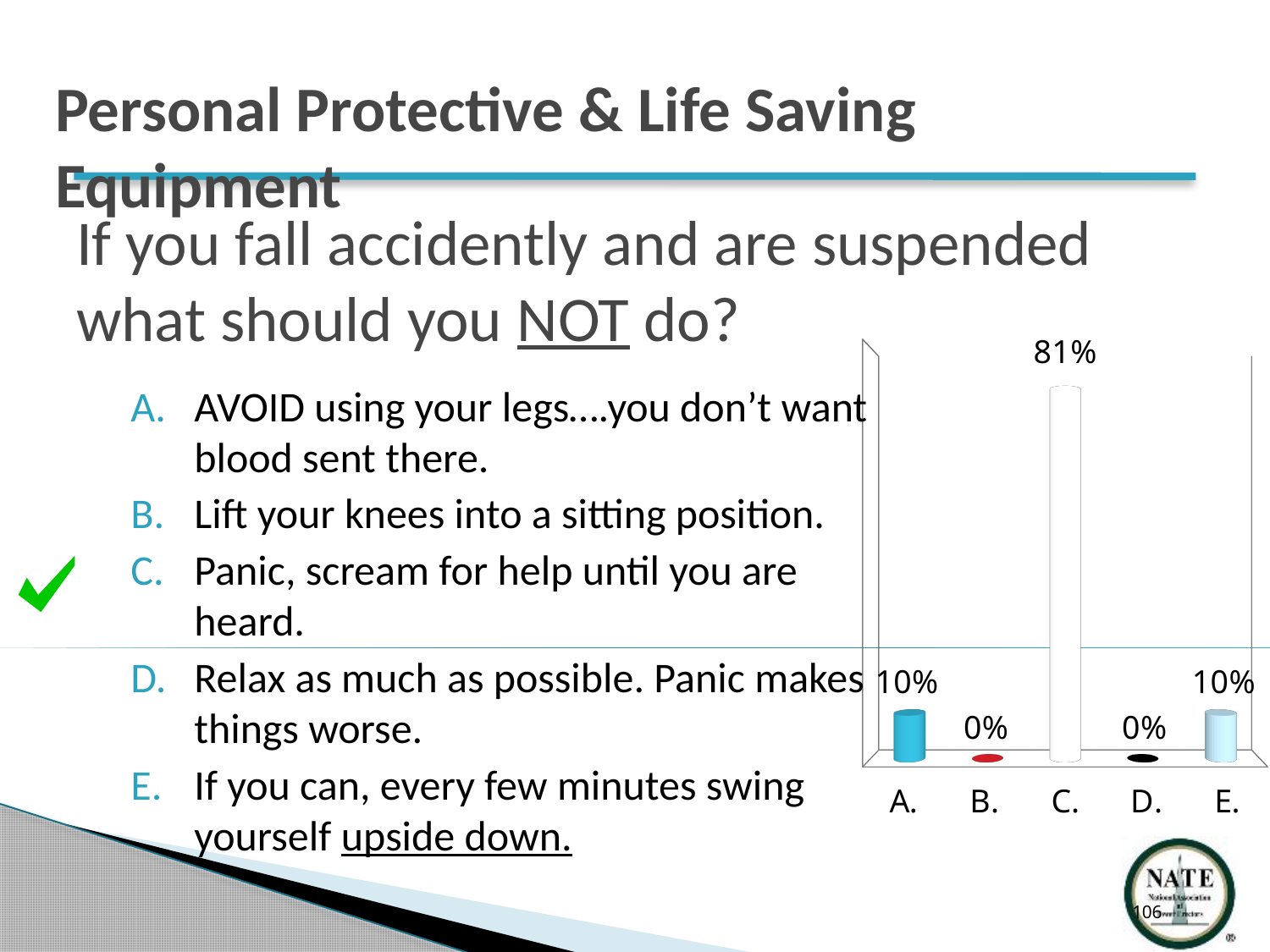
What is the difference between the values for E. and D. in the chart? 10% What is the value for category B. in the chart? 0% What is the value for category A. in the chart? 10% How many categories in the chart have a value of 0%? 2 What is the value for category E. in the chart? 10% What is the value for category C. in the chart? 81% Which category has the highest value in the chart? C. What kind of chart is shown on the slide? bar chart What is the difference between the values for C. and A. in the chart? 71% How many categories are shown in the chart? 5 Which is larger in the chart, the value for C. or the value for E.? C. Which is larger in the chart, the value for A. or the value for B.? A.